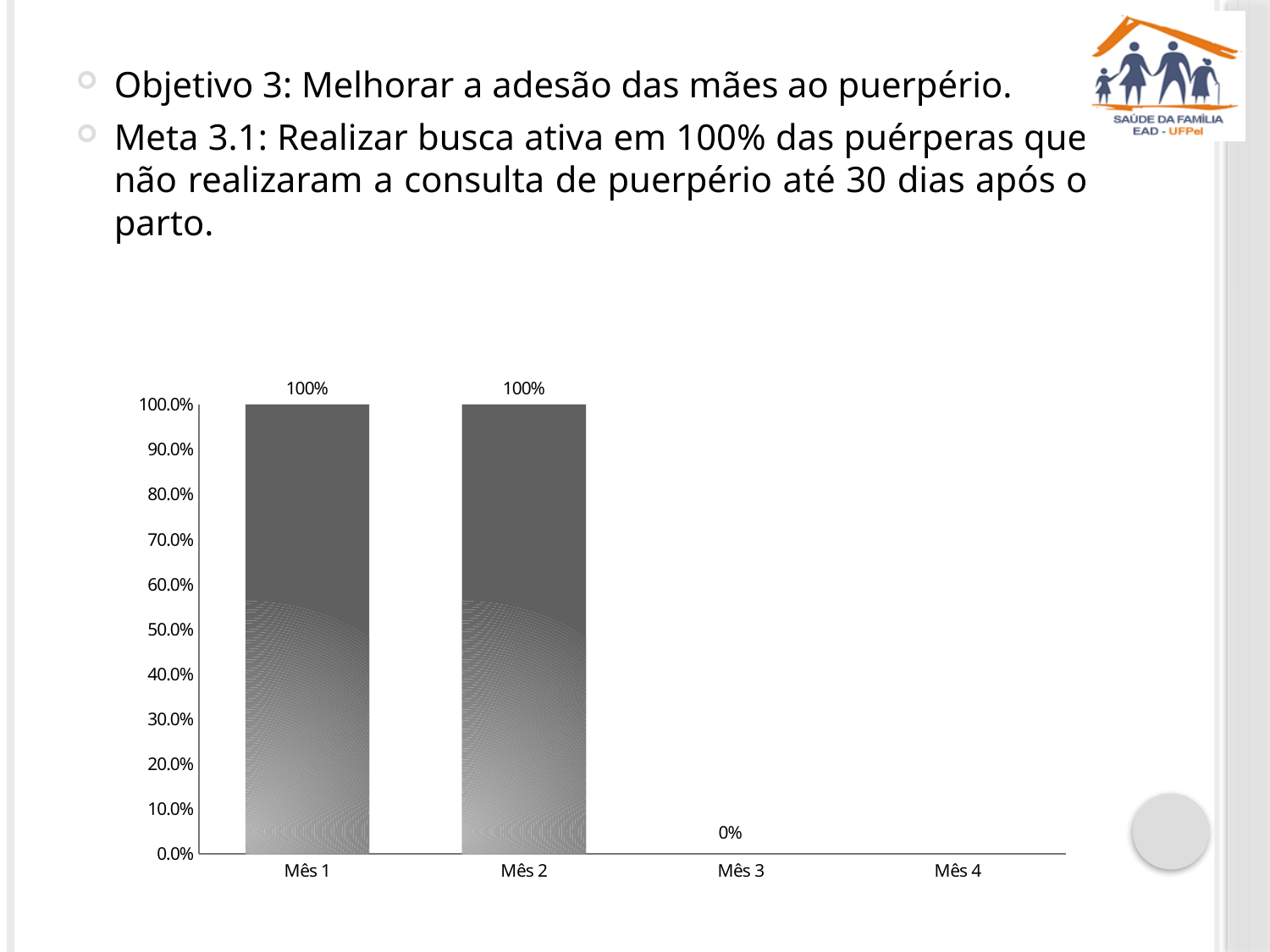
What is the label of the first category on the x axis? Mês 1 Are the values for Mês 1 and Mês 2 equal? Yes How many categories are shown on the x axis? 4 Which is larger, the value for Mês 1 or the value for Mês 3? Mês 1 What is the difference between the value for Mês 2 and the value for Mês 3? 100% What is the value for Mês 1? 100% What is the value for Mês 2? 100% What is the highest tick label on the y axis? 100.0% Is the value for Mês 2 greater or less than 50.0%? greater Does the value rise or fall from Mês 2 to Mês 3? fall What kind of chart is shown on the slide? bar chart What is the value for Mês 3? 0%